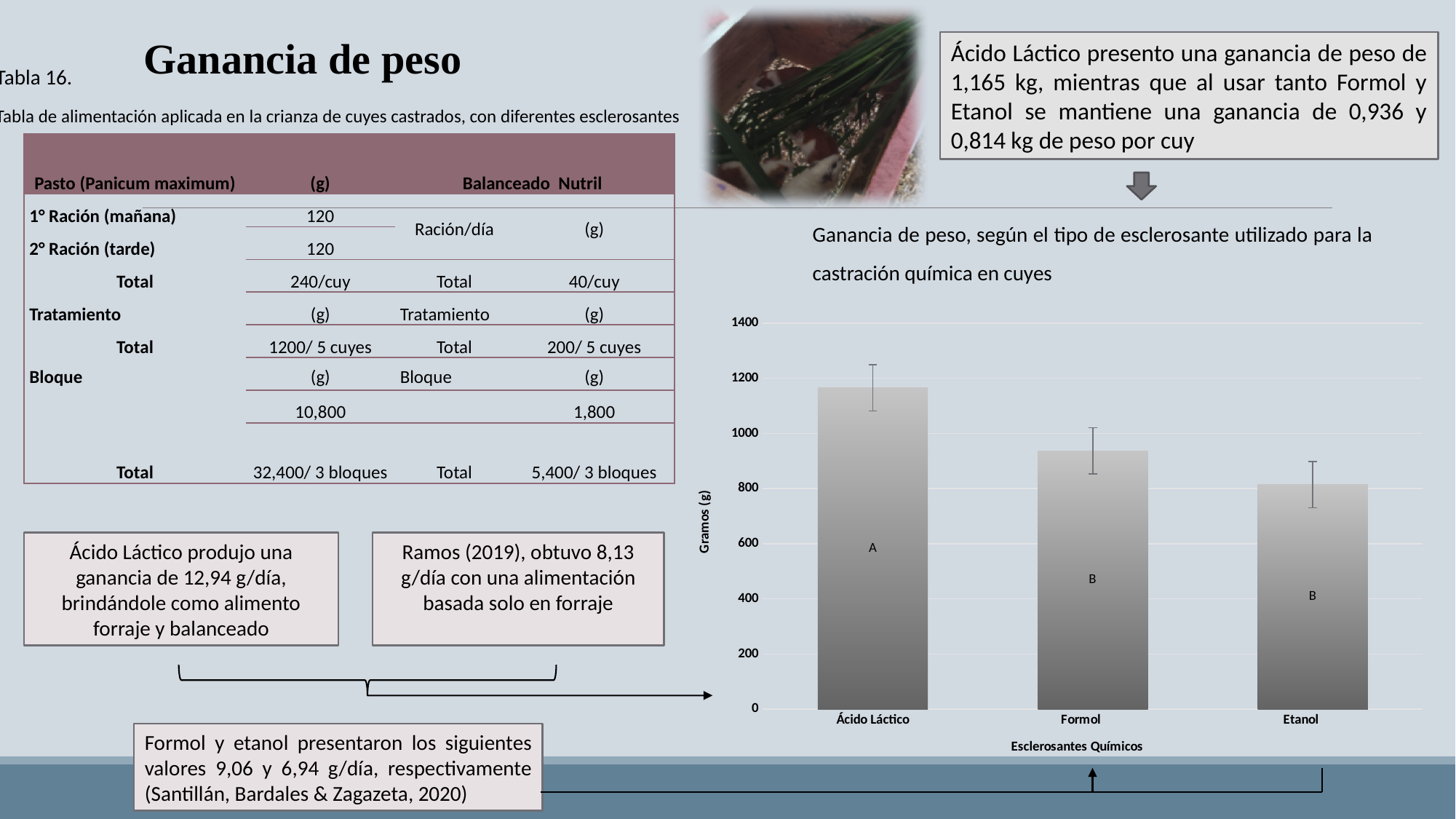
How many esclerosantes (categories) are plotted in the bar chart? 3 Do the bar values rise or fall from left to right across the x axis of the bar chart? fall What is the title of the horizontal axis of the bar chart? Esclerosantes Químicos In the bar chart, which has the larger value, Formol or Etanol? Formol What kind of chart is shown on the right side of the slide? bar chart Is the value for Ácido Láctico in the bar chart greater or less than 1000? greater Which esclerosante has the lowest weight gain in the bar chart? Etanol Which esclerosante has the highest weight gain in the bar chart? Ácido Láctico Is the value for Etanol in the bar chart greater or less than 600? greater Is the value for Formol in the bar chart greater or less than 800? greater What is the title of the vertical axis of the bar chart? Gramos (g)